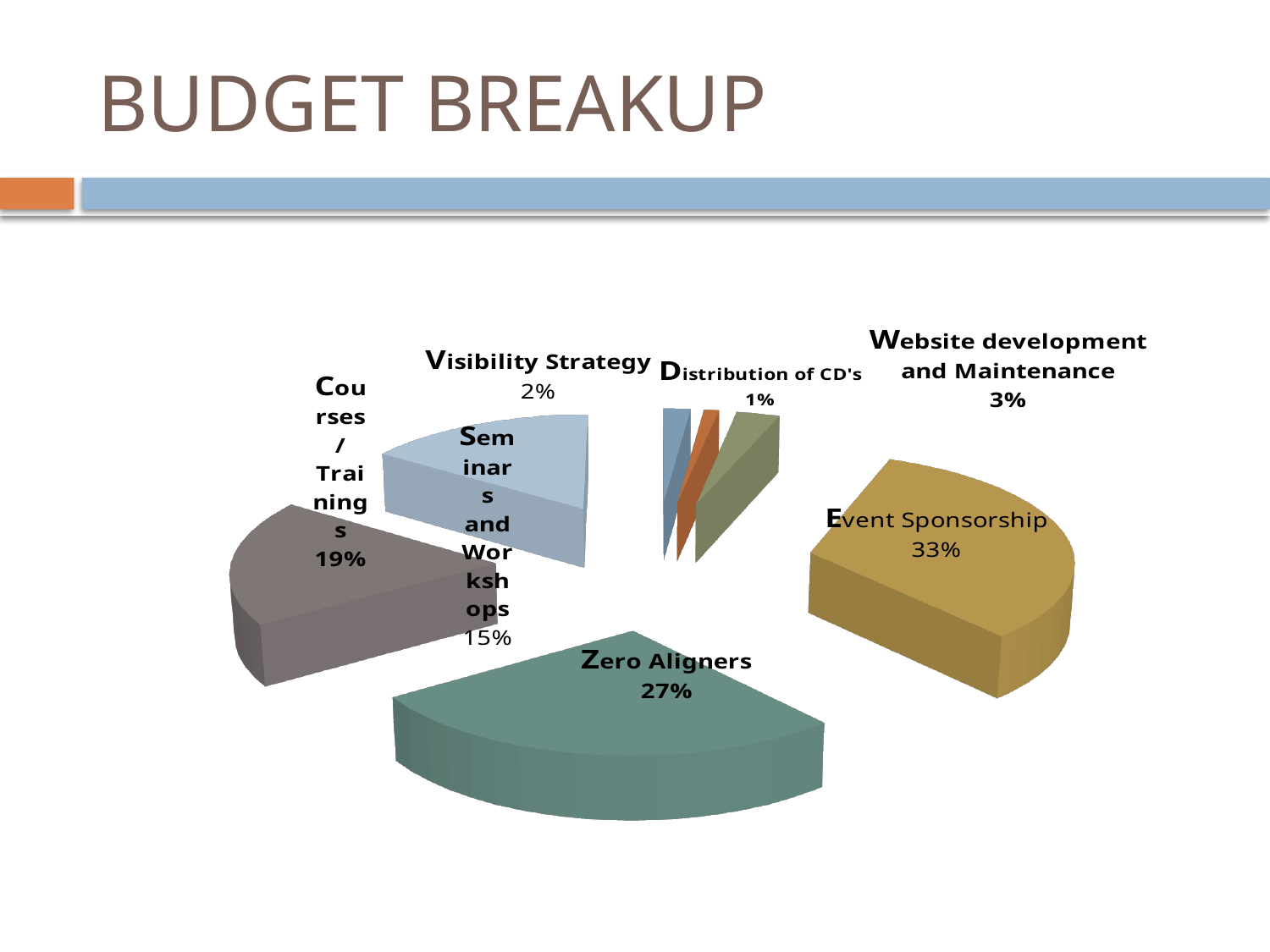
What share of the budget goes to Event Sponsorship? 33% What kind of chart is shown on the slide? Pie chart How many slices does the pie chart have? 7 Which category has the smallest share of the budget? Distribution of CD's What is the difference in percentage points between Event Sponsorship and Zero Aligners? 6 Which is larger, the share for Courses/Trainings or the share for Seminars and Workshops? Courses/Trainings What percentage is shown for Seminars and Workshops? 15% What share of the budget goes to Zero Aligners? 27% What percentage is shown for Distribution of CD's? 1% What percentage is shown for Website development and Maintenance? 3% What is the title of the slide containing the pie chart? BUDGET BREAKUP Which category has the largest share of the budget? Event Sponsorship